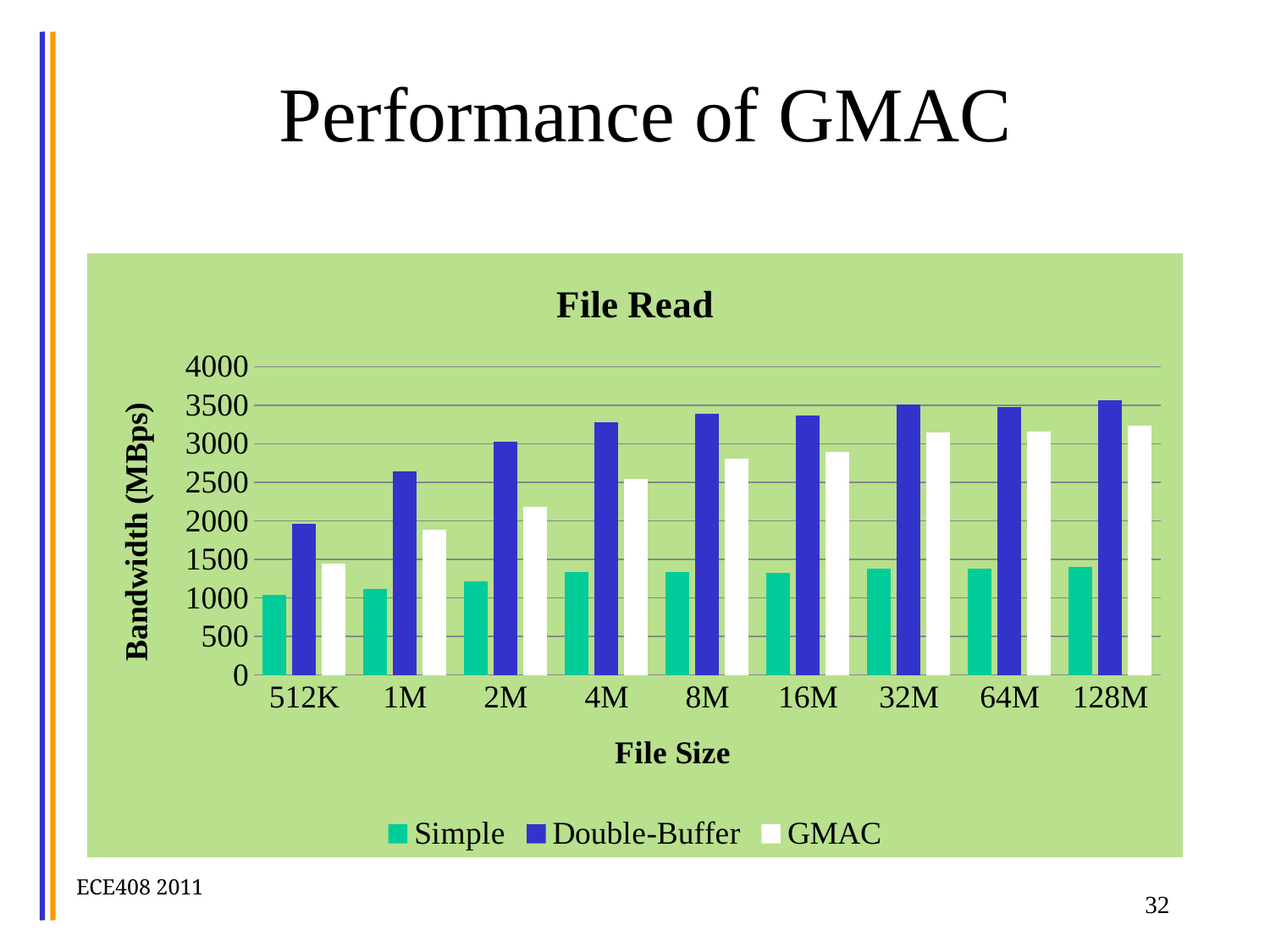
For which file size is the Double-Buffer bandwidth lowest? 512K Is the Simple value for 128M greater or less than 1500? less How many series does the legend list? 3 Do the GMAC values rise or fall as file size increases along the x axis? rise Is the GMAC value for 8M greater or less than 3000? less Is the GMAC value for 2M greater or less than 2000? greater What is the label of the y axis? Bandwidth (MBps) How many file sizes are shown on the x axis? 9 At 4M, which is larger: Double-Buffer or GMAC? Double-Buffer What kind of chart is shown on the slide? bar chart What is the title of the chart? File Read